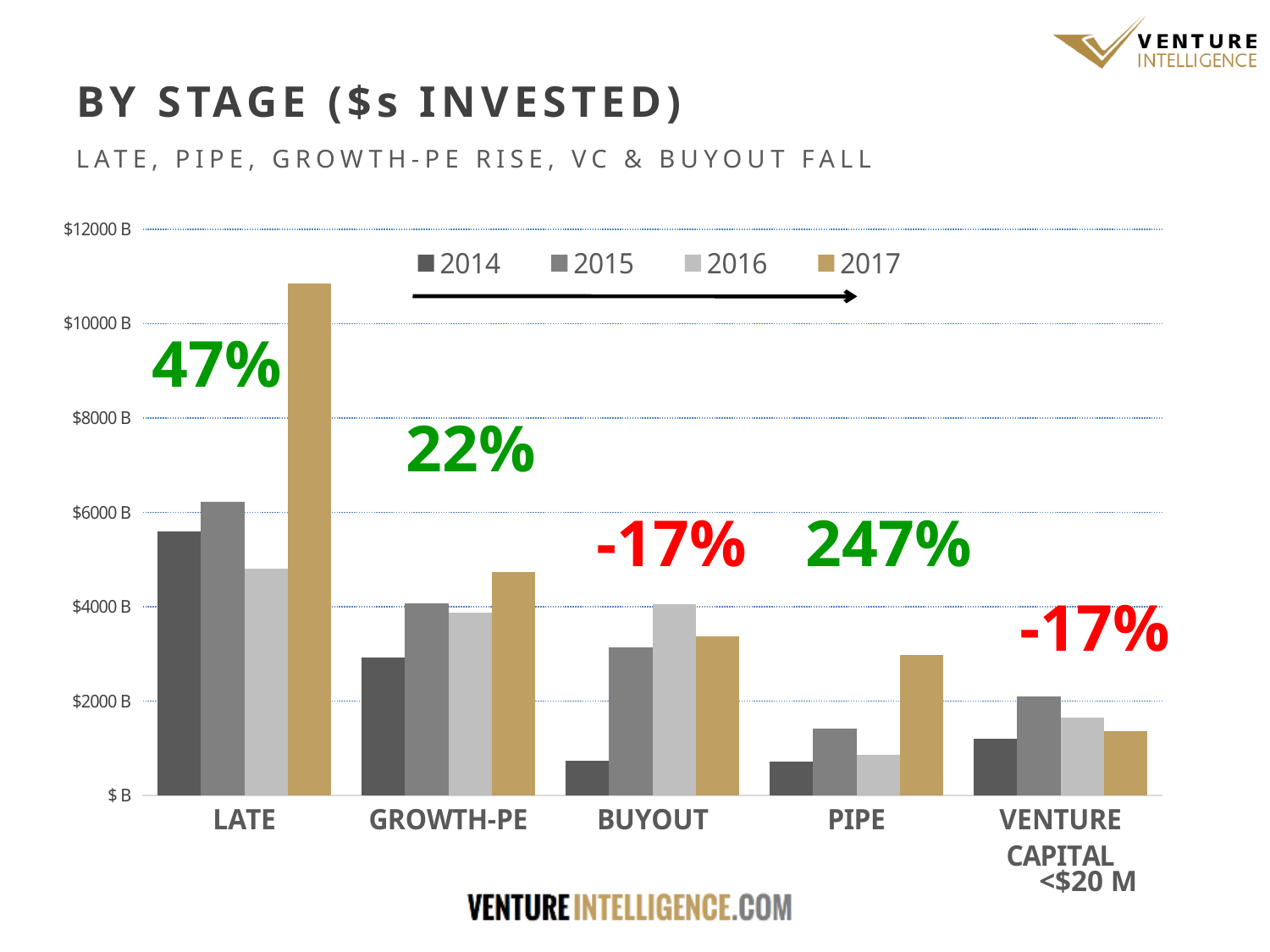
What percentage change is printed above the PIPE bars? 247% Is the 2017 value for GROWTH-PE greater or less than $4000 B? greater Is the 2014 value for LATE greater or less than $6000 B? less Which category has the tallest bar in the chart? LATE Is the 2017 value for LATE greater or less than $10000 B? greater Which year has the highest value for LATE? 2017 For PIPE, which is larger: the 2014 value or the 2017 value? 2017 What kind of chart is shown on the slide? bar chart For BUYOUT, which is larger: the 2016 value or the 2017 value? 2016 How many stage categories are shown on the x axis? 5 How many series does the legend list? 4